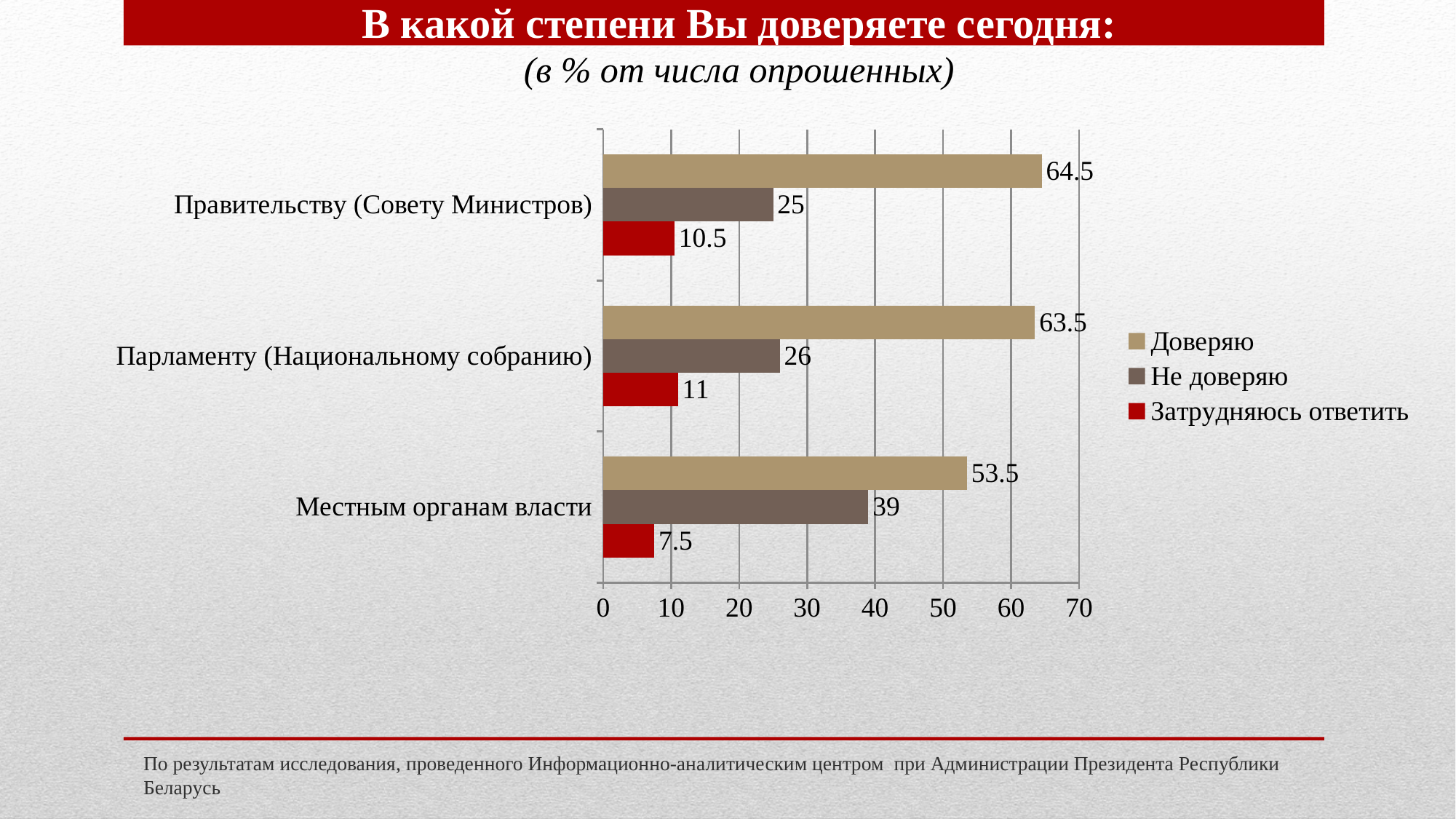
What is the value for "Не доверяю" for Местным органам власти? 39 What kind of chart is shown on the slide? bar chart Which colour represents the "Затрудняюсь ответить" series? red How many series does the legend list? 3 Which category has the lowest "Затрудняюсь ответить" value? Местным органам власти Is the "Не доверяю" value for Местным органам власти greater or less than 30? greater Which is larger: the "Доверяю" value for Парламенту (Национальному собранию) or for Местным органам власти? Парламенту (Национальному собранию) What is the difference between the "Не доверяю" values for Местным органам власти and Правительству (Совету Министров)? 14 Which category has the highest "Доверяю" value? Правительству (Совету Министров) How many categories are shown on the chart? 3 What is the value for "Доверяю" for Правительству (Совету Министров)? 64.5 What is the value for "Затрудняюсь ответить" for Парламенту (Национальному собранию)? 11